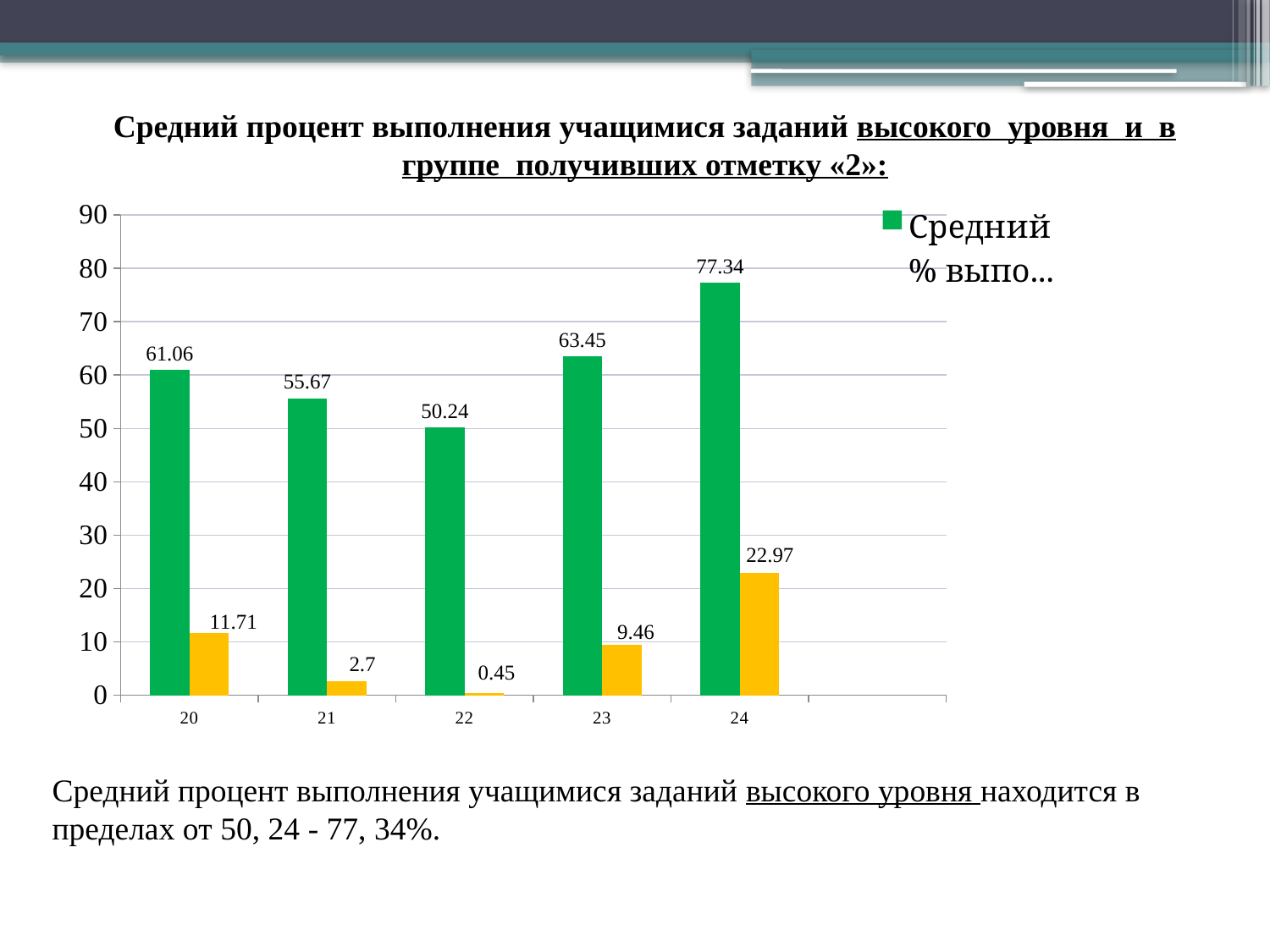
How many categories are shown on the x axis? 5 Which category has the lowest yellow bar? 22 Is the green bar value for category 23 greater or less than 60? greater What is the value of the green bar for category 24? 77.34 What is the value of the yellow bar for category 22? 0.45 What type of chart is shown on the slide? bar chart Which is larger: the yellow bar for category 20 or the yellow bar for category 23? category 20 Which category has the highest green bar? 24 What is the value of the yellow bar for category 24? 22.97 What is the difference between the green bar values for categories 24 and 22? 27.1 What is the value of the green bar for category 21? 55.67 Which category has the lowest green bar? 22